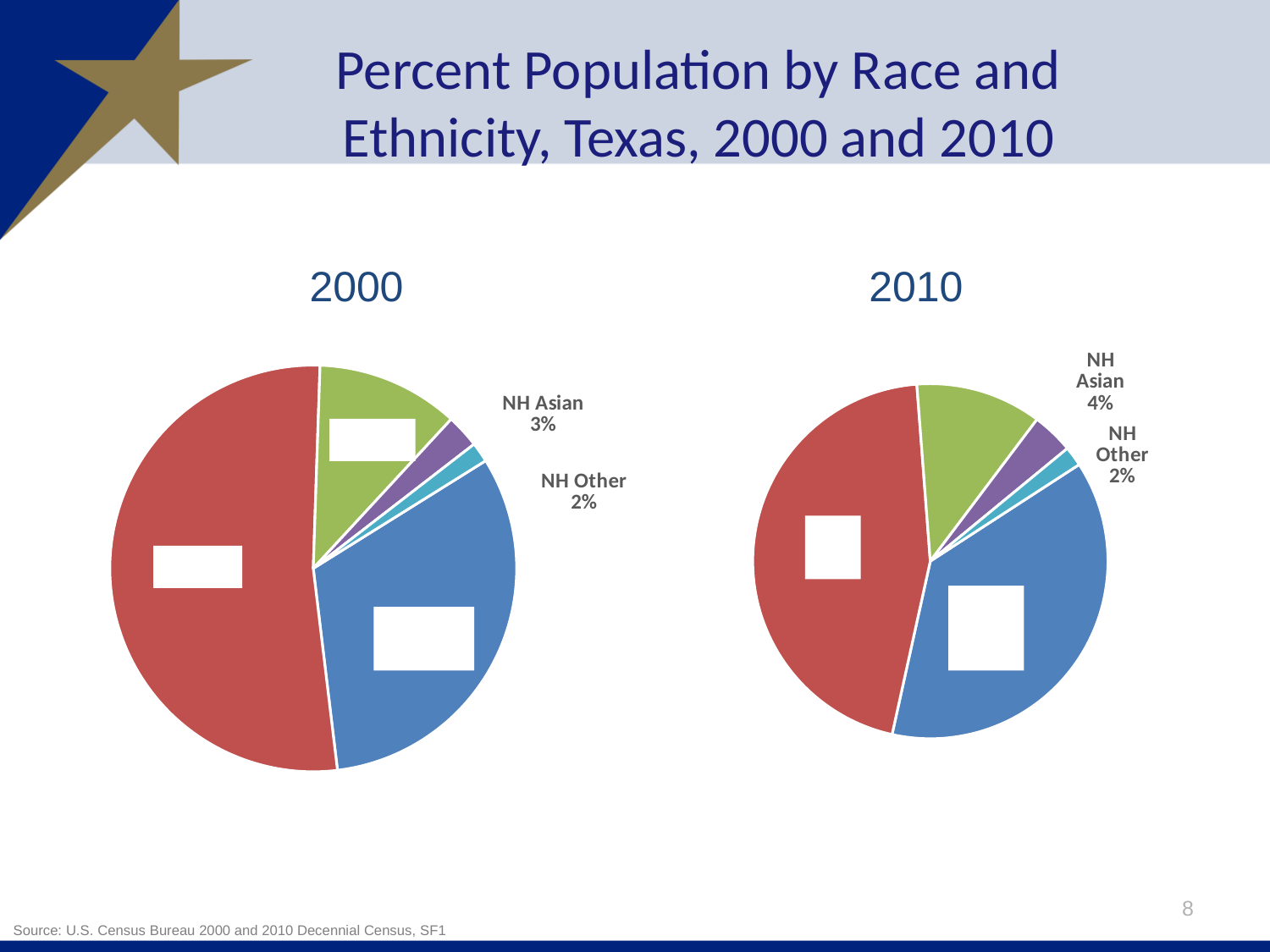
In the 2010 pie chart, what is the difference between the NH Asian and NH Other shares? 2% Comparing the two pie charts, is the NH Asian share larger in 2000 or in 2010? 2010 How many slices does the 2000 pie chart have? 5 In the 2000 pie chart, what colour is the largest slice? Red In the 2010 pie chart, what percent of the population is NH Other? 2% In the 2000 pie chart, which is larger, NH Asian or NH Other? NH Asian What kind of chart is used for the 2000 data? Pie chart How many slices does the 2010 pie chart have? 5 What is the difference between the NH Asian share in 2010 and in 2000? 1% In the 2010 pie chart, what percent of the population is NH Asian? 4% In the 2000 pie chart, what percent of the population is NH Other? 2% In the 2000 pie chart, what percent of the population is NH Asian? 3%